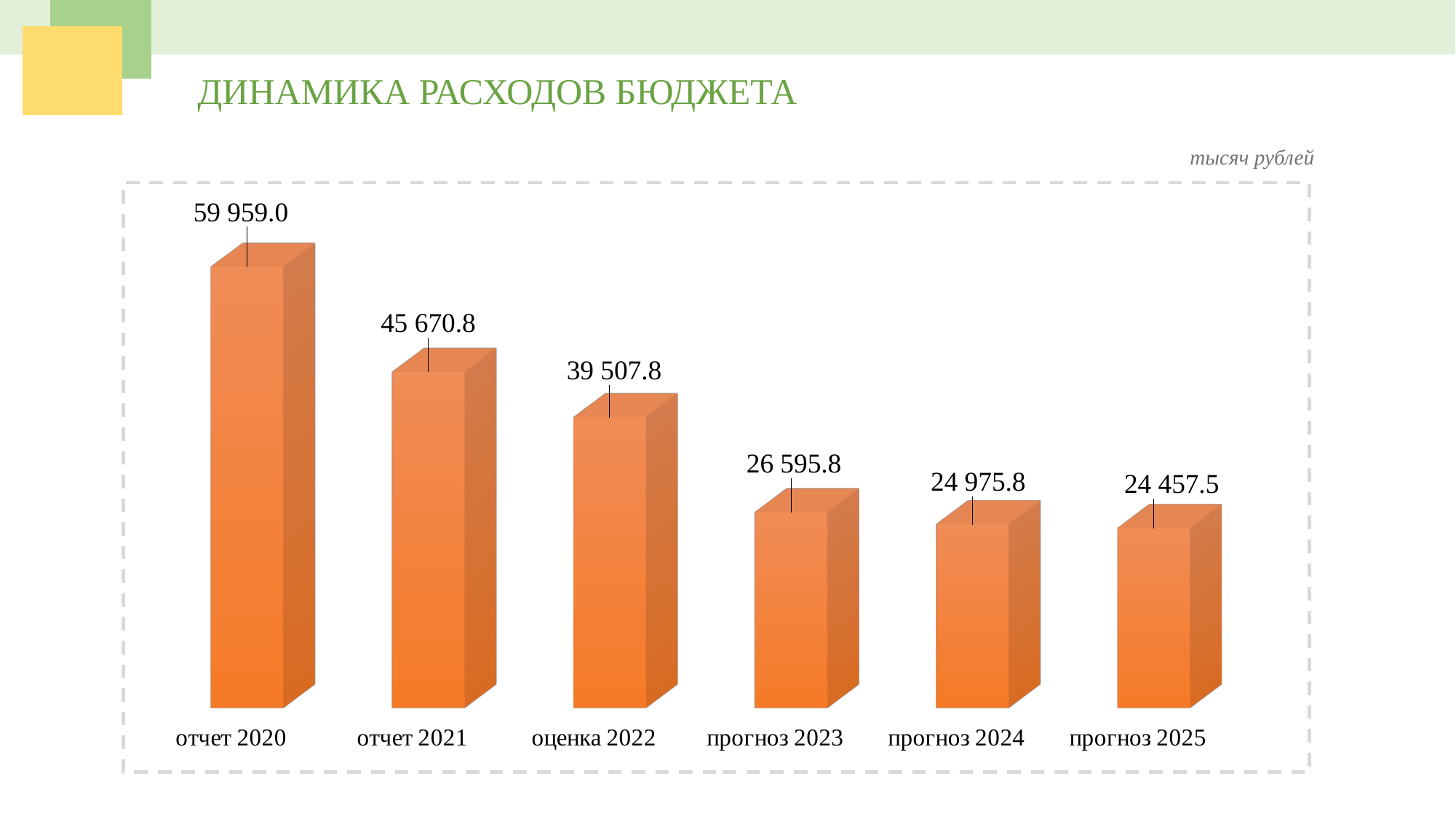
What is the value for отчет 2020? 59 959.0 What is the value for прогноз 2025? 24 457.5 What is the difference between the values for отчет 2020 and отчет 2021? 14 288.2 What is the value for прогноз 2023? 26 595.8 What is the difference between the values for отчет 2021 and оценка 2022? 6 163.0 How many categories are shown in the chart? 6 What is the difference between the values for прогноз 2024 and прогноз 2025? 518.3 Which is larger, the value for оценка 2022 or the value for прогноз 2023? оценка 2022 What kind of chart is shown on the slide? bar chart Which category has the lowest value? прогноз 2025 Which category has the highest value? отчет 2020 Do the values rise or fall from отчет 2020 to прогноз 2025? fall